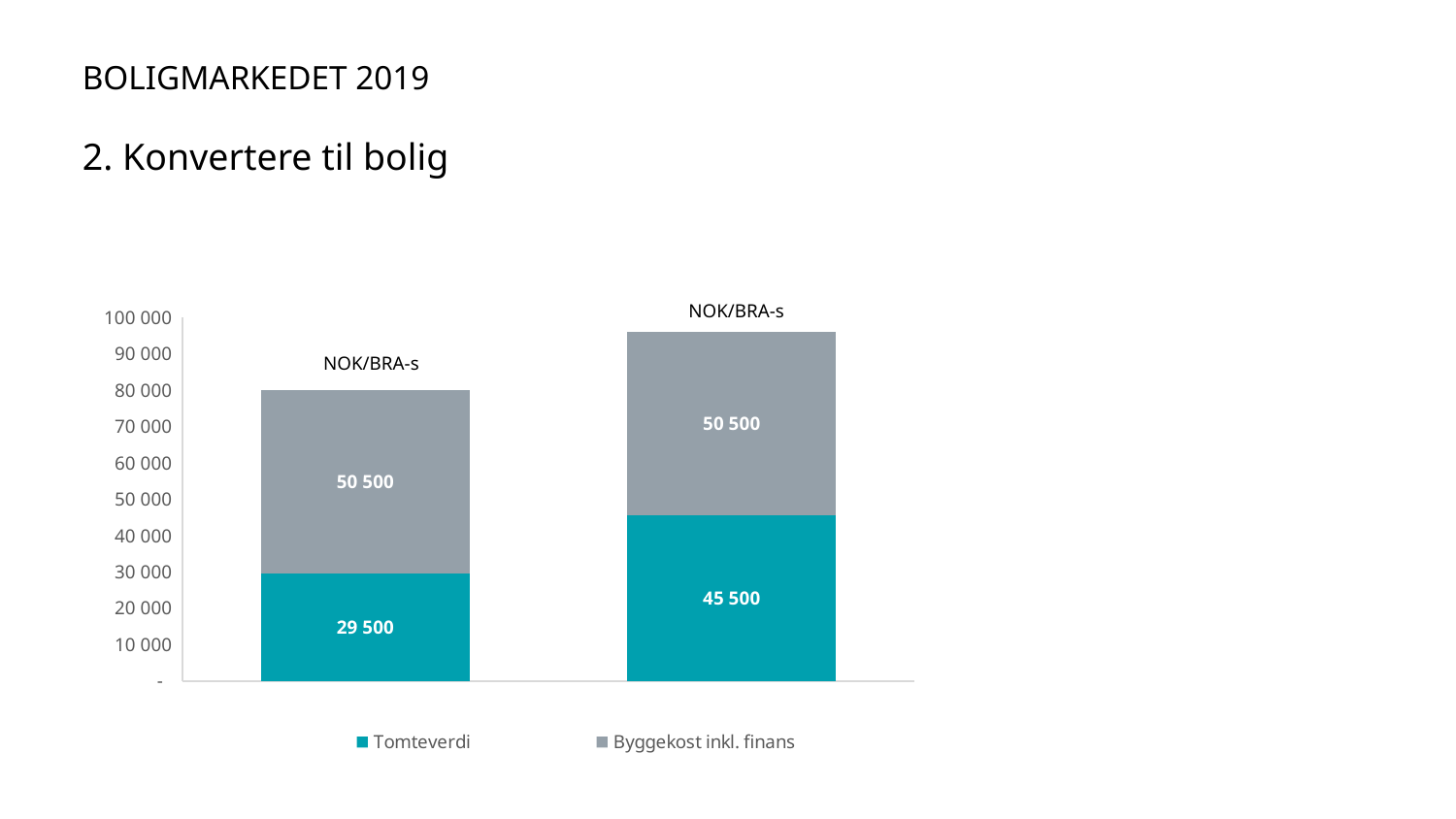
What is the Byggekost inkl. finans value for the left bar? 50 500 What is the Byggekost inkl. finans value for the right bar? 50 500 How many bars are plotted in the chart? 2 Which series is shown in teal in the legend? Tomteverdi What is the difference between the Tomteverdi values of the right and left bars? 16 000 How many series does the legend list? 2 What kind of chart is shown on the slide? stacked bar chart Which bar has the larger Tomteverdi value, the left or the right? right What is the Tomteverdi value for the right bar? 45 500 What is the total of the right stacked bar? 96 000 What is the Tomteverdi value for the left bar? 29 500 What is the total of the left stacked bar? 80 000